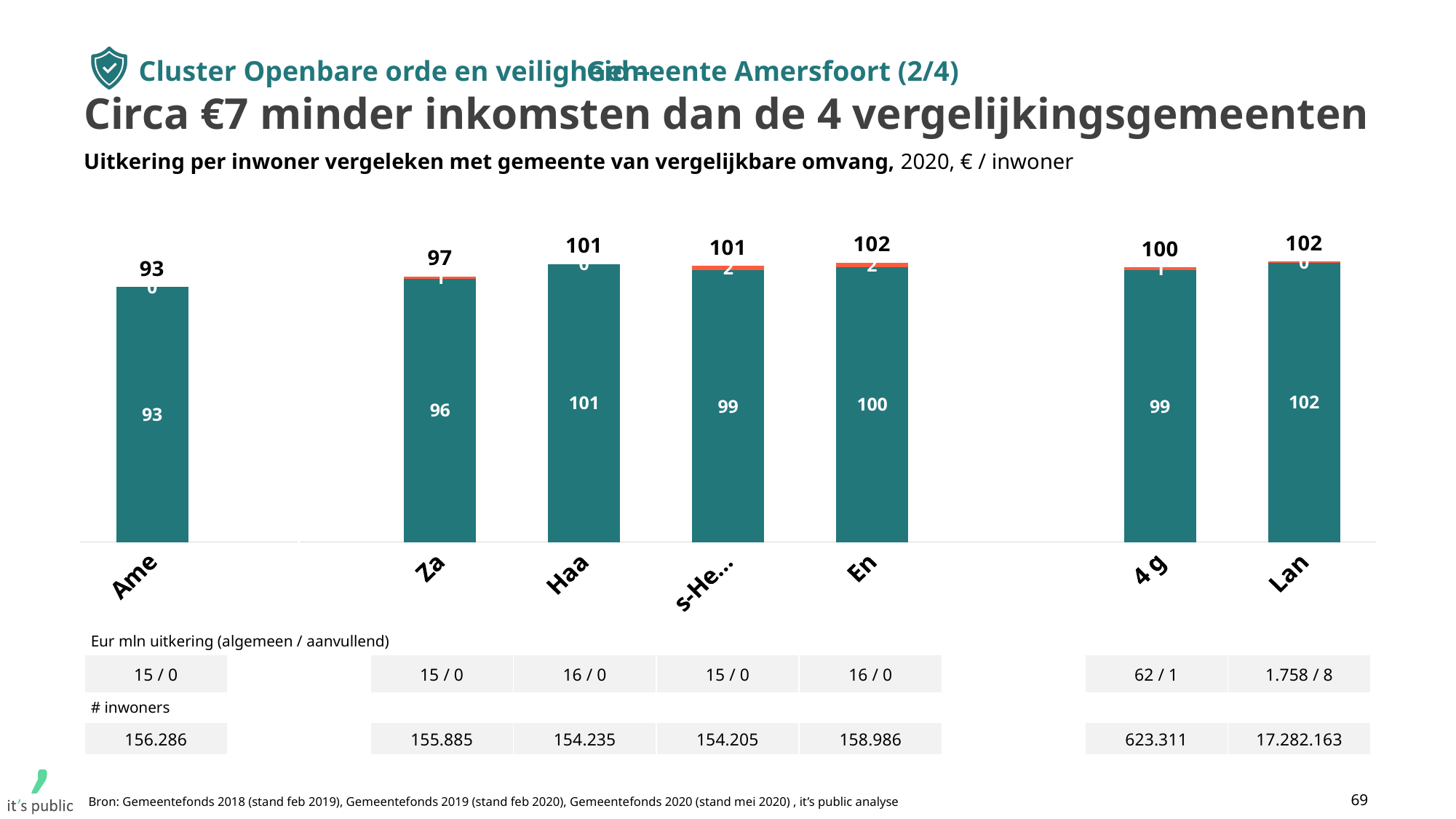
What value is printed inside the teal segment of the bar for Lan? 102 Which category has the lowest total value? Ame What is the total value labelled above the bar for Ame? 93 By how much does the total for Za exceed the total for Ame? 4 What value is printed inside the teal segment of the bar for Za? 96 What is the difference between the total for Lan and the total for Ame? 9 What value is printed in the orange segment of the bar for En? 2 What is the total of the stacked bar for 4 g? 100 What kind of chart is shown on the slide? Stacked bar chart How many categories are shown on the x axis of the chart? 7 Which has a higher total value, Haa or Za? Haa In what unit are the chart values expressed, according to the subtitle? € / inwoner